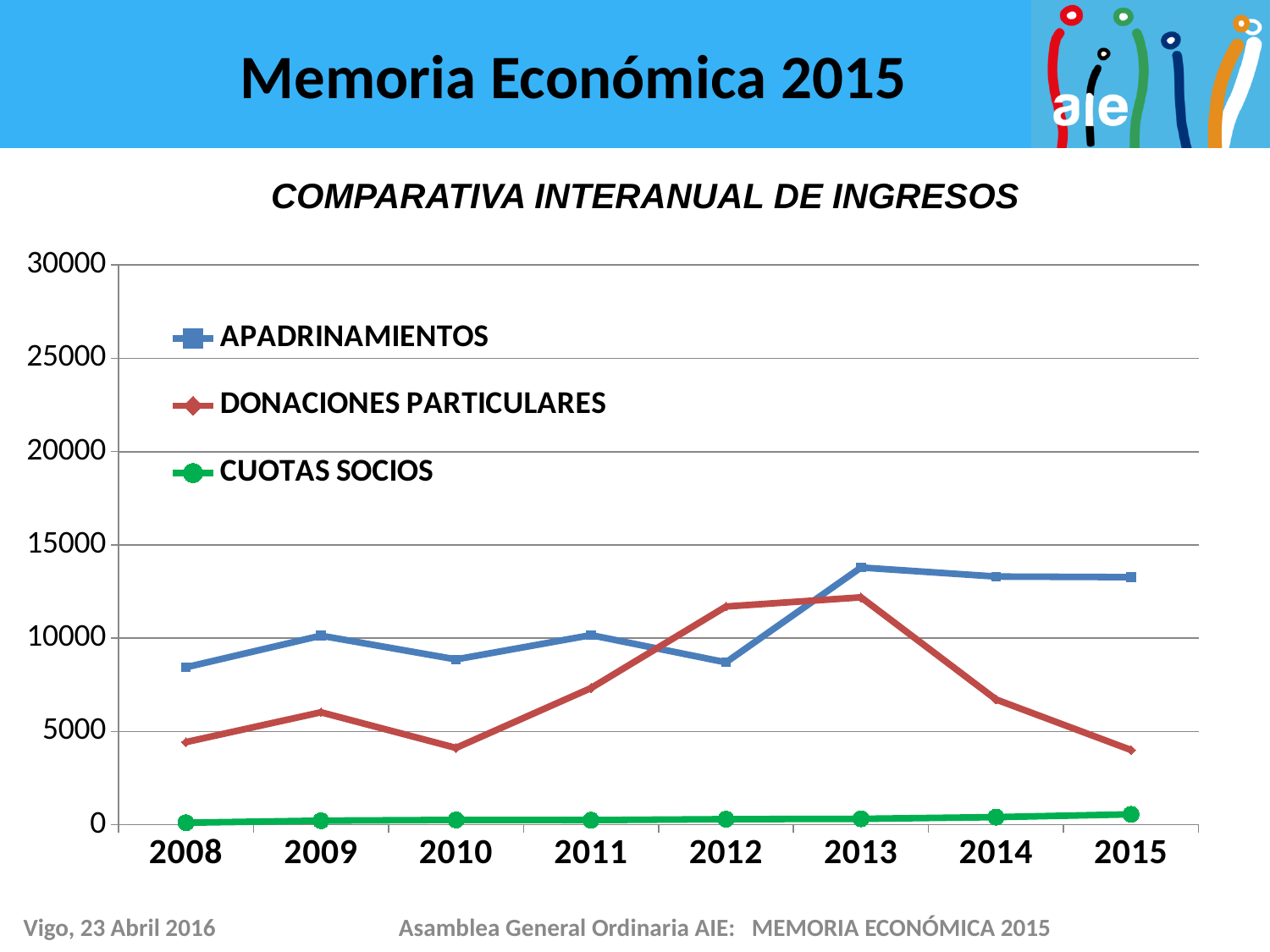
What kind of chart is shown on the slide? Line chart In 2012, which is larger: APADRINAMIENTOS or DONACIONES PARTICULARES? DONACIONES PARTICULARES Is the value for DONACIONES PARTICULARES in 2012 greater or less than 10000? greater How many years are plotted along the x axis? 8 How many series does the legend list? 3 In 2015, which is larger: APADRINAMIENTOS or DONACIONES PARTICULARES? APADRINAMIENTOS In which year does APADRINAMIENTOS reach its highest value? 2013 Does DONACIONES PARTICULARES rise or fall from 2013 to 2015? Fall In which year does APADRINAMIENTOS have its lowest value? 2008 Is the value for DONACIONES PARTICULARES in 2010 greater or less than 5000? less Is the value for APADRINAMIENTOS in 2013 greater or less than 10000? greater What is the title of the chart? COMPARATIVA INTERANUAL DE INGRESOS